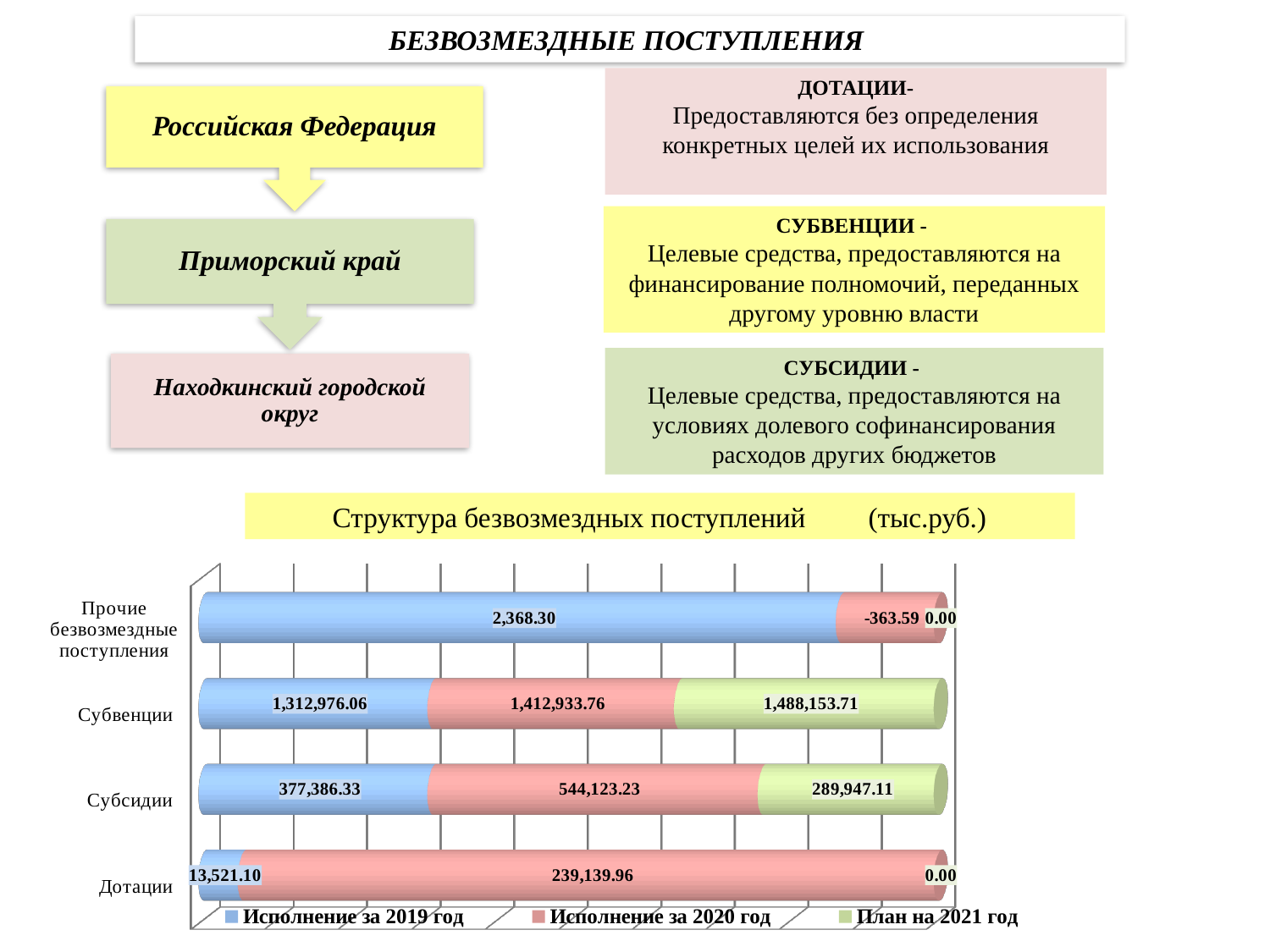
What is the difference between 'Исполнение за 2020 год' and 'Исполнение за 2019 год' for 'Субвенции'? 99,957.70 What is the value of 'Исполнение за 2020 год' for 'Субвенции'? 1,412,933.76 What is the value of 'Исполнение за 2020 год' for 'Прочие безвозмездные поступления'? -363.59 Which category has the highest value for 'План на 2021 год'? Субвенции How many categories are shown on the chart's vertical axis? 4 What kind of chart is shown under the heading 'Структура безвозмездных поступлений'? bar chart For 'Субсидии', which is larger: 'Исполнение за 2019 год' or 'Исполнение за 2020 год'? Исполнение за 2020 год Which category has the lowest value for 'Исполнение за 2020 год'? Прочие безвозмездные поступления What is the value of 'Исполнение за 2019 год' for 'Дотации'? 13,521.10 What is the value of 'План на 2021 год' for 'Субсидии'? 289,947.11 How many series does the chart legend list? 3 In what units are the chart values given, according to the chart heading? тыс.руб.